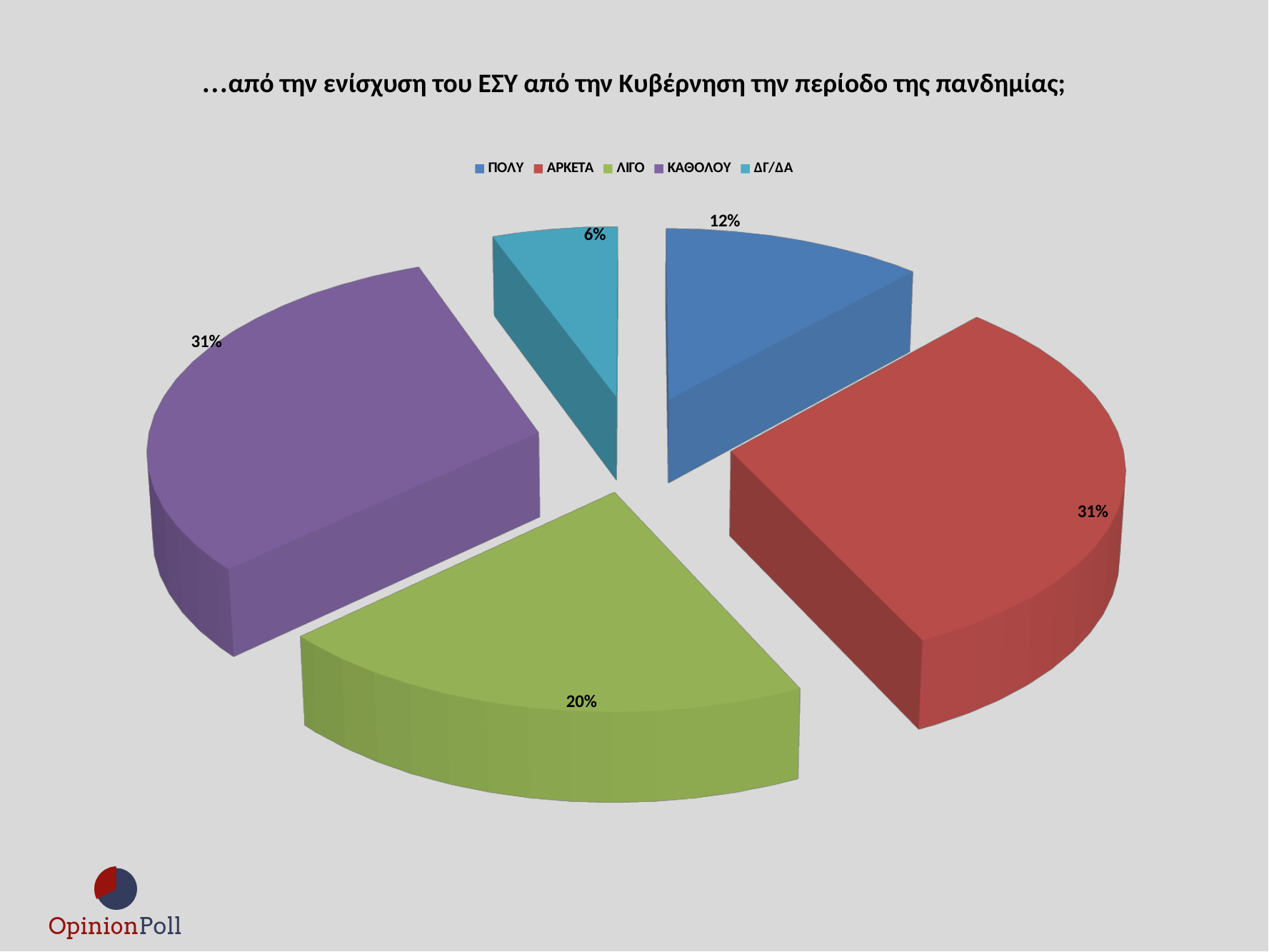
Which is larger, the share for ΛΙΓΟ or the share for ΠΟΛΥ? ΛΙΓΟ How many categories does the legend list? 5 What percentage is shown for ΚΑΘΟΛΟΥ? 31% How many slices does the pie chart have? 5 What is the difference between the shares of ΛΙΓΟ and ΠΟΛΥ? 8% What percentage is shown for ΑΡΚΕΤΑ? 31% What percentage is shown for ΛΙΓΟ? 20% What colour is the slice for ΚΑΘΟΛΟΥ? Purple What percentage is shown for ΔΓ/ΔΑ? 6% What type of chart is shown on the slide? Pie chart What percentage is shown for ΠΟΛΥ? 12% Which category has the smallest share of the pie? ΔΓ/ΔΑ